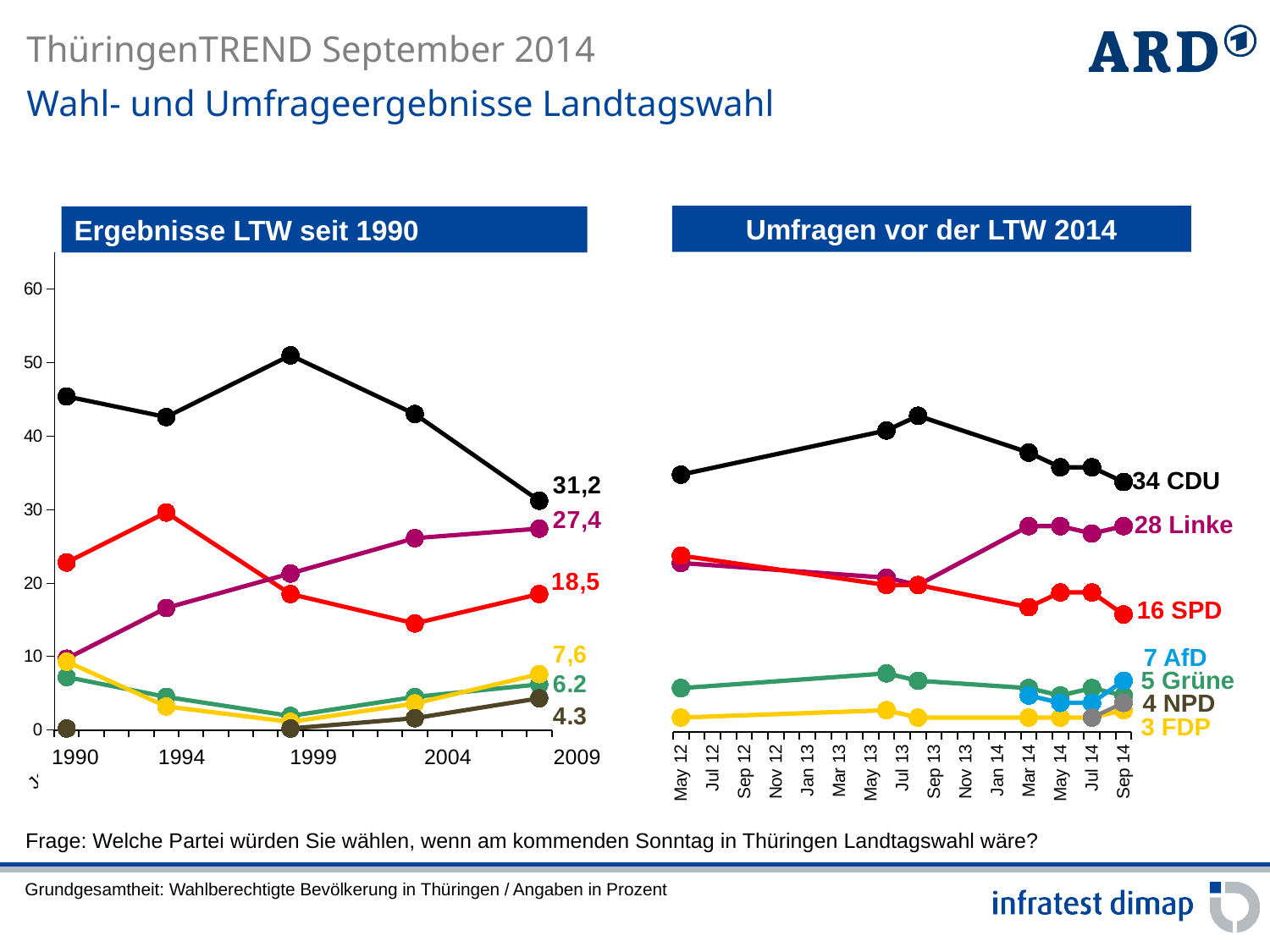
In the 'Umfragen vor der LTW 2014' chart, which party has the highest value at Sep 14? CDU In the 'Umfragen vor der LTW 2014' chart, which is larger at Sep 14, the value for AfD or the value for Grüne? AfD In the 'Umfragen vor der LTW 2014' chart, what is the difference between the labelled values for CDU and Linke at Sep 14? 6 In the 'Umfragen vor der LTW 2014' chart, what is the value labelled for CDU at Sep 14? 34 How many election years are shown on the x axis of the 'Ergebnisse LTW seit 1990' chart? 5 How many parties are labelled in the 'Umfragen vor der LTW 2014' chart? 7 In the 'Umfragen vor der LTW 2014' chart, what is the value labelled for Linke at Sep 14? 28 What kind of chart is the 'Ergebnisse LTW seit 1990' chart on the left? line chart In the 'Umfragen vor der LTW 2014' chart, which party has the lowest value at Sep 14? FDP In the 'Ergebnisse LTW seit 1990' chart, is the value of the black line in 1990 greater or less than 40? greater In the 'Umfragen vor der LTW 2014' chart, what is the value labelled for SPD at Sep 14? 16 In the 'Ergebnisse LTW seit 1990' chart, what is the highest value labelled at 2009? 31,2